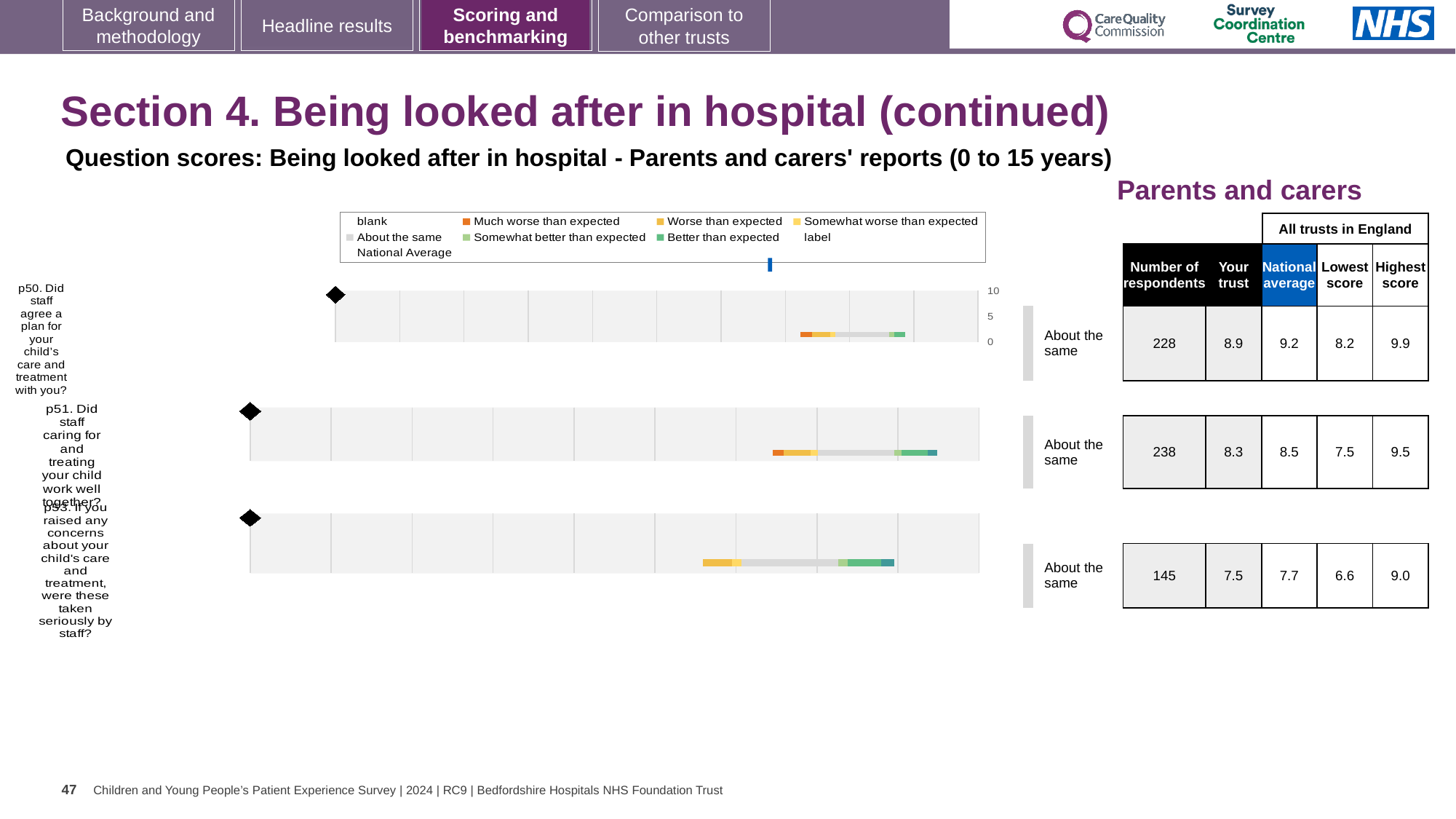
How many respondents answered question p53 (If you raised any concerns about your child's care and treatment, were these taken seriously by staff?)? 145 Which of the three questions shown has the highest 'Your trust' score? p50 What kind of chart is used to show the question scores on this slide? Bar chart For question p50 (Did staff agree a plan for your child's care and treatment with you?), what is the 'Your trust' score? 8.9 How many survey questions are plotted on this slide? 3 What is the lowest score among all trusts in England for question p53? 6.6 What is the highest score among all trusts in England for question p50? 9.9 Which of the three questions shown has the fewest respondents? p53 For question p53, what is the difference between the national average and the 'Your trust' score? 0.2 What benchmark category is shown for question p50? About the same For question p51 (Did staff caring for and treating your child work well together?), what is the national average score? 8.5 Is the 'Your trust' score higher for question p51 or question p53? p51